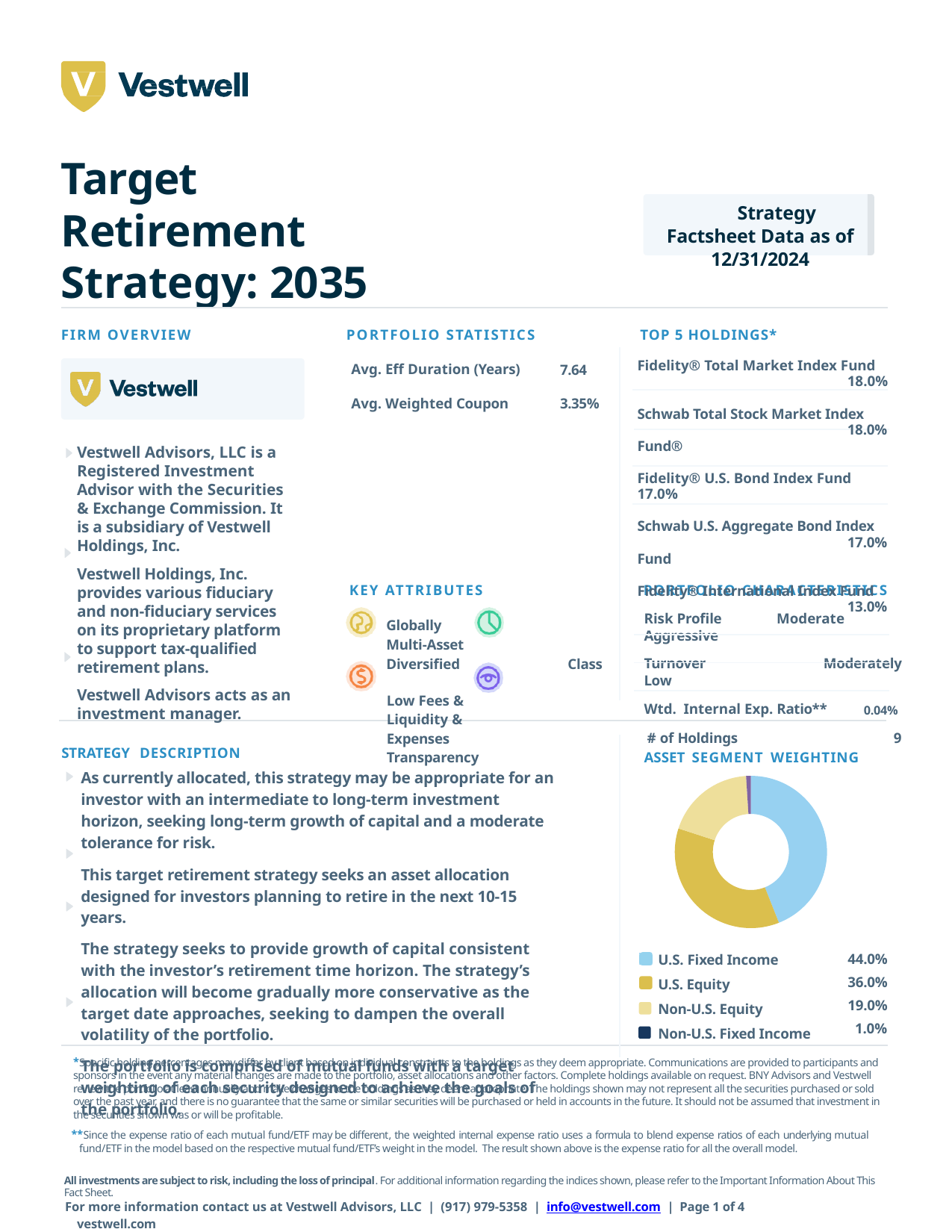
In the Asset Segment Weighting chart, which is larger: U.S. Equity or Non-U.S. Equity? U.S. Equity Which asset segment has the largest weighting in the Asset Segment Weighting chart? U.S. Fixed Income In the Asset Segment Weighting chart, what is the weighting for U.S. Fixed Income? 44.0% In the Asset Segment Weighting chart, what is the weighting for Non-U.S. Fixed Income? 1.0% In the Asset Segment Weighting chart, what is the combined weighting of U.S. Equity and Non-U.S. Equity? 55.0% Which asset segment has the smallest weighting in the Asset Segment Weighting chart? Non-U.S. Fixed Income What kind of chart is shown under Asset Segment Weighting? Donut (pie) chart In the Asset Segment Weighting chart, which asset segment is shown in light blue? U.S. Fixed Income In the Asset Segment Weighting chart, what is the difference between the U.S. Fixed Income and U.S. Equity weightings? 8.0% How many asset segments are shown in the Asset Segment Weighting chart? 4 In the Asset Segment Weighting chart, what is the weighting for U.S. Equity? 36.0% In the Asset Segment Weighting chart, what is the weighting for Non-U.S. Equity? 19.0%